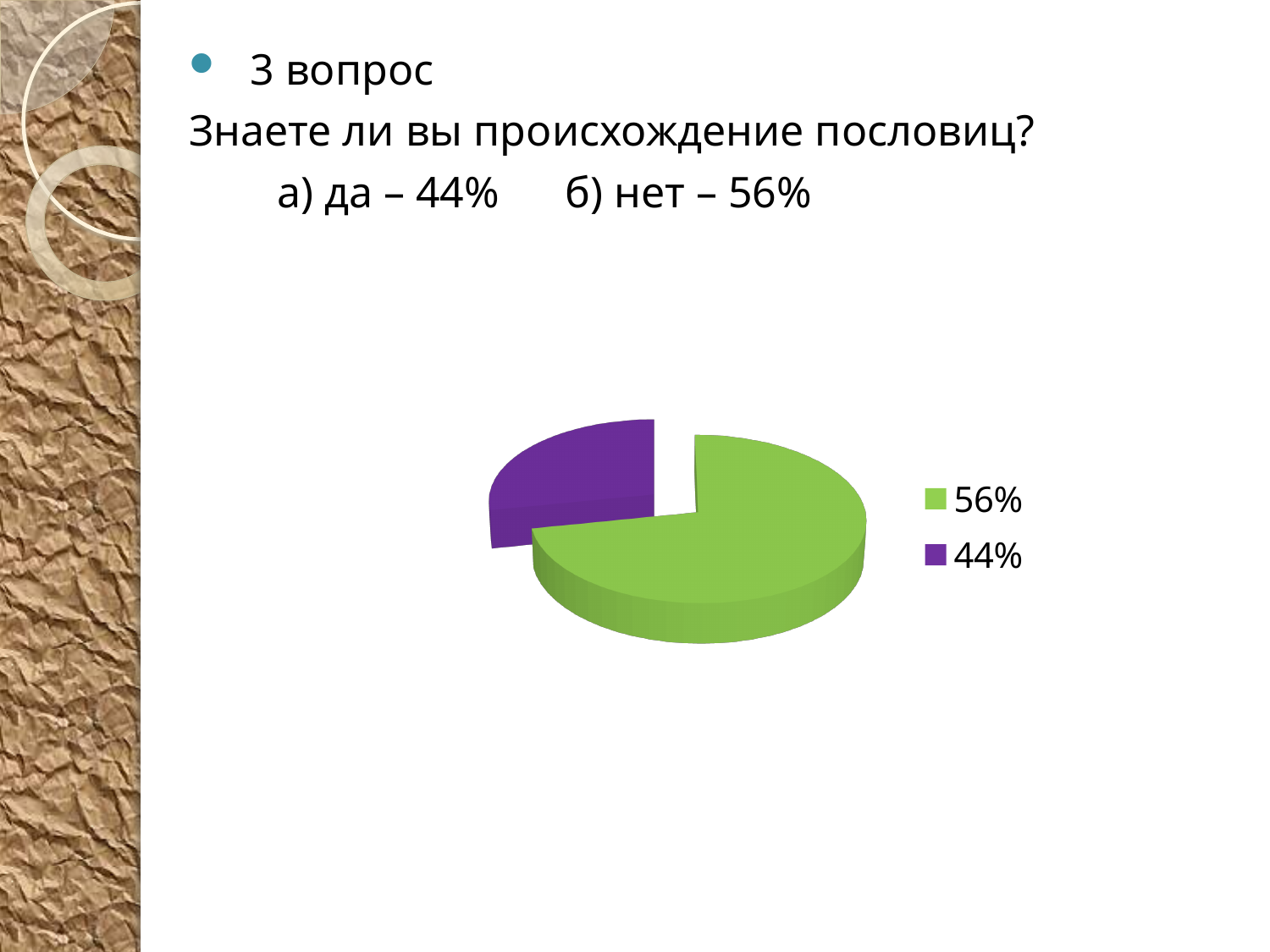
Which is larger, the green slice or the purple slice? the green slice Which slice of the pie chart is the largest? the green slice (56%) What kind of chart is shown on the slide? pie chart How many slices does the pie chart have? 2 What colour is the slice labelled 44% in the legend? purple Which slice of the pie chart is the smallest? the purple slice (44%) How many entries does the legend of the pie chart list? 2 What colour is the slice labelled 56% in the legend? green